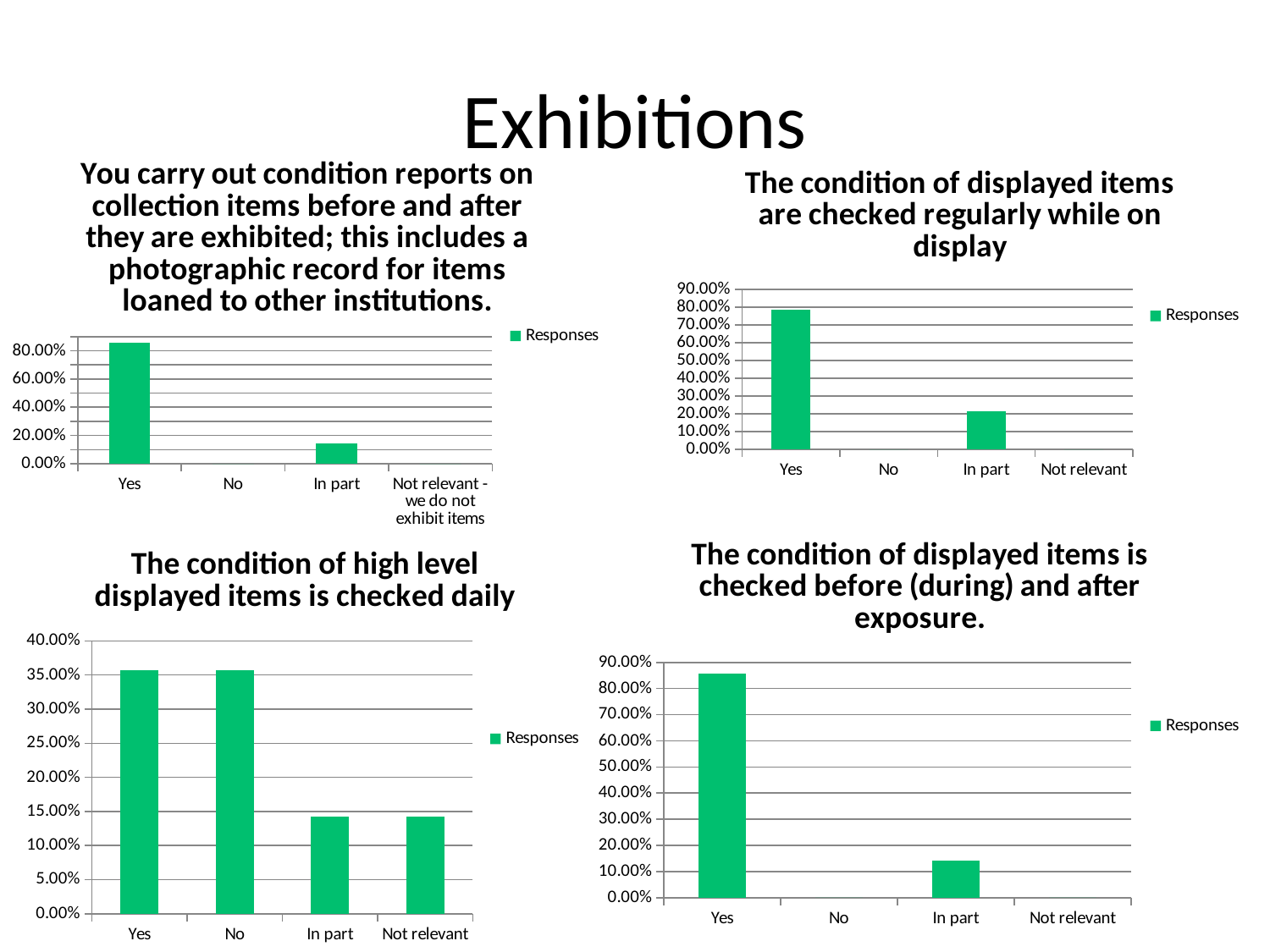
In the bottom-left chart (condition of high level displayed items checked daily), is the value for In part greater or less than 10.00%? greater In the bottom-left chart (condition of high level displayed items checked daily), is the value for Yes greater or less than 30.00%? greater How many categories are shown on the x axis of the bottom-left chart (condition of high level displayed items checked daily)? 4 In the top-right chart (condition of displayed items checked regularly while on display), which is larger, Yes or In part? Yes How many series does the legend of the bottom-right chart (condition checked before, during and after exposure) list? 1 In the bottom-right chart (condition checked before, during and after exposure), is the value for Yes greater or less than 80.00%? greater In the top-left chart (condition reports before and after exhibition), which category has the highest value? Yes In the bottom-left chart (condition of high level displayed items checked daily), which is larger, Yes or In part? Yes What kind of chart is the top-left chart (condition reports before and after exhibition)? bar chart